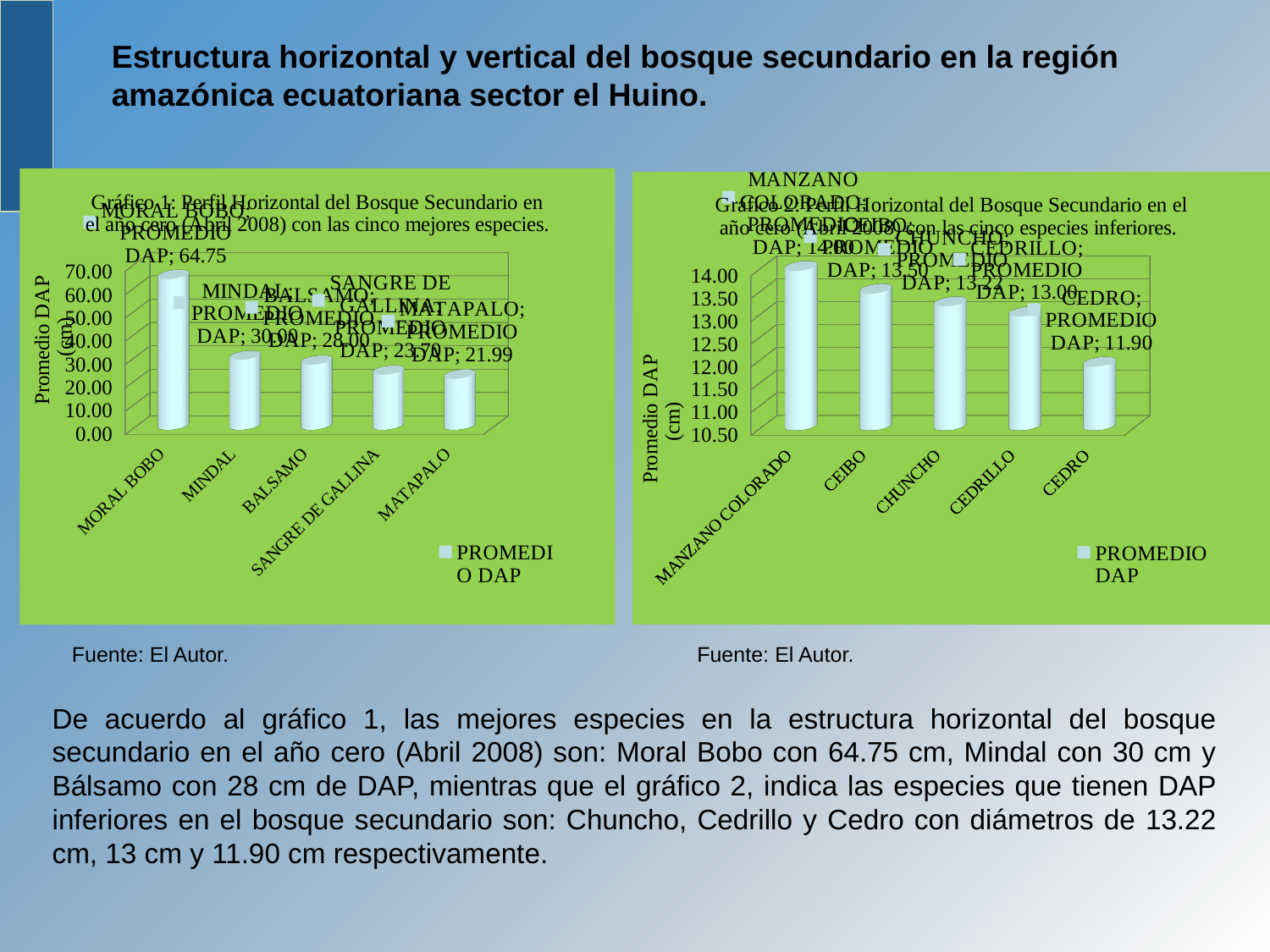
What kind of chart is Gráfico 1 (left chart)? bar chart In Gráfico 1 (left chart), what is the difference between the PROMEDIO DAP of MINDAL and BALSAMO? 2.00 In Gráfico 1 (left chart), which species has the lowest PROMEDIO DAP? MATAPALO In Gráfico 2 (right chart), do the values rise or fall from left to right along the x axis? fall In Gráfico 2 (right chart), what is the PROMEDIO DAP value for CHUNCHO? 13.22 In Gráfico 1 (left chart), how many species are plotted? 5 In Gráfico 2 (right chart), which is larger, the PROMEDIO DAP of CEIBO or CEDRILLO? CEIBO In Gráfico 2 (right chart), what is the PROMEDIO DAP value for CEDRO? 11.90 In Gráfico 1 (left chart), what is the PROMEDIO DAP value for MORAL BOBO? 64.75 In Gráfico 2 (right chart), which species has the highest PROMEDIO DAP? MANZANO COLORADO In Gráfico 1 (left chart), which species has the highest PROMEDIO DAP? MORAL BOBO In Gráfico 1 (left chart), what is the PROMEDIO DAP value for MATAPALO? 21.99